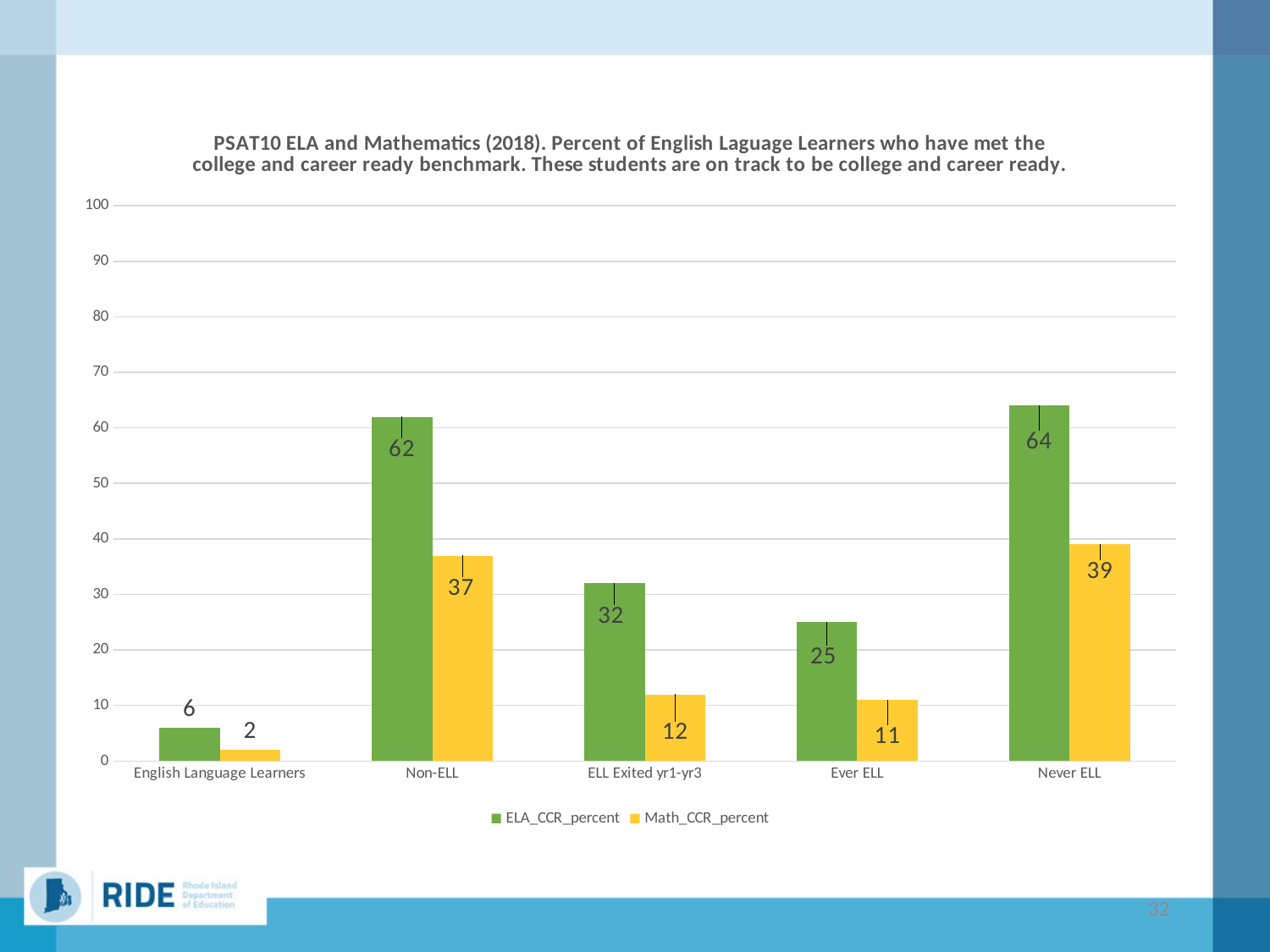
What is the ELA_CCR_percent value for Non-ELL? 62 What is the difference between the ELA_CCR_percent values for Never ELL and Non-ELL? 2 What kind of chart is shown on the slide? bar chart Which category has the lowest Math_CCR_percent value? English Language Learners What is the difference between the ELA_CCR_percent and Math_CCR_percent values for ELL Exited yr1-yr3? 20 Is the ELA_CCR_percent value for Ever ELL greater or less than 30? less How many categories are shown on the x axis? 5 Which category has the highest ELA_CCR_percent value? Never ELL How many series does the legend list? 2 What is the Math_CCR_percent value for English Language Learners? 2 Which is larger, the Math_CCR_percent value for Non-ELL or for Never ELL? Never ELL What is the Math_CCR_percent value for Ever ELL? 11